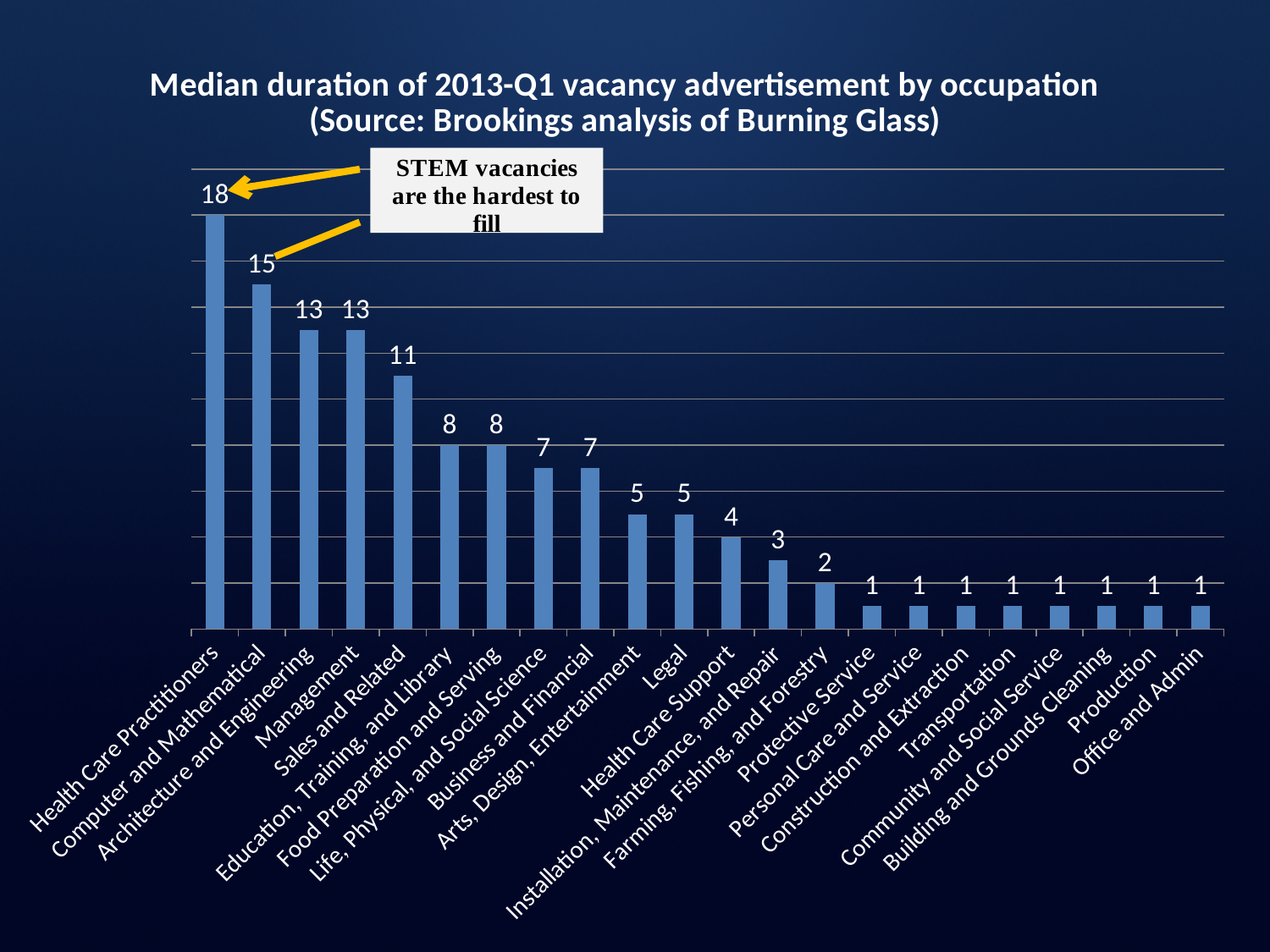
Which occupation has the highest median vacancy duration? Health Care Practitioners Which is larger, the value for Sales and Related or the value for Business and Financial? Sales and Related What is the difference between the values for Health Care Practitioners and Computer and Mathematical? 3 How many occupation categories are shown in the chart? 22 What is the value shown for Sales and Related? 11 What is the difference between the values for Management and Legal? 8 What kind of chart is shown on the slide? Bar chart What is the value shown for Farming, Fishing, and Forestry? 2 Do the values rise or fall moving from left to right along the x axis? Fall What is the median vacancy duration for Health Care Practitioners? 18 What is the value shown for Computer and Mathematical? 15 What is the value shown for Health Care Support? 4